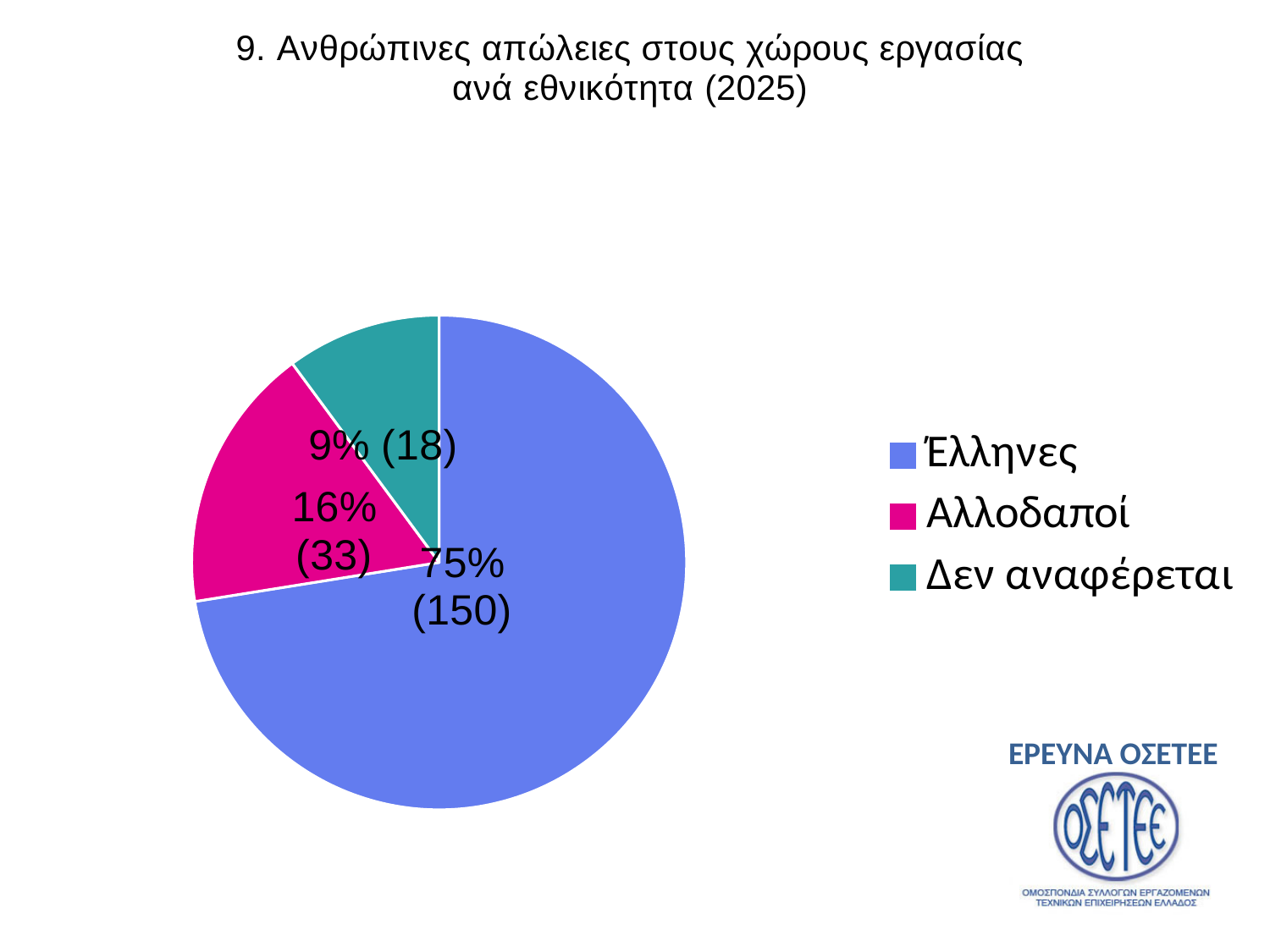
What share of the pie does Αλλοδαποί represent? 16% What is the count shown for Έλληνες? 150 What is the difference between the counts for Αλλοδαποί and Δεν αναφέρεται? 15 Which category has the largest slice? Έλληνες Which category has the smallest slice? Δεν αναφέρεται How many categories does the pie chart have? 3 What share of the pie does Έλληνες represent? 75% What kind of chart is shown on the slide? pie chart What share of the pie does Δεν αναφέρεται represent? 9% What is the count shown for Αλλοδαποί? 33 What is the count shown for Δεν αναφέρεται? 18 What is the title of the chart? 9. Ανθρώπινες απώλειες στους χώρους εργασίας ανά εθνικότητα (2025)